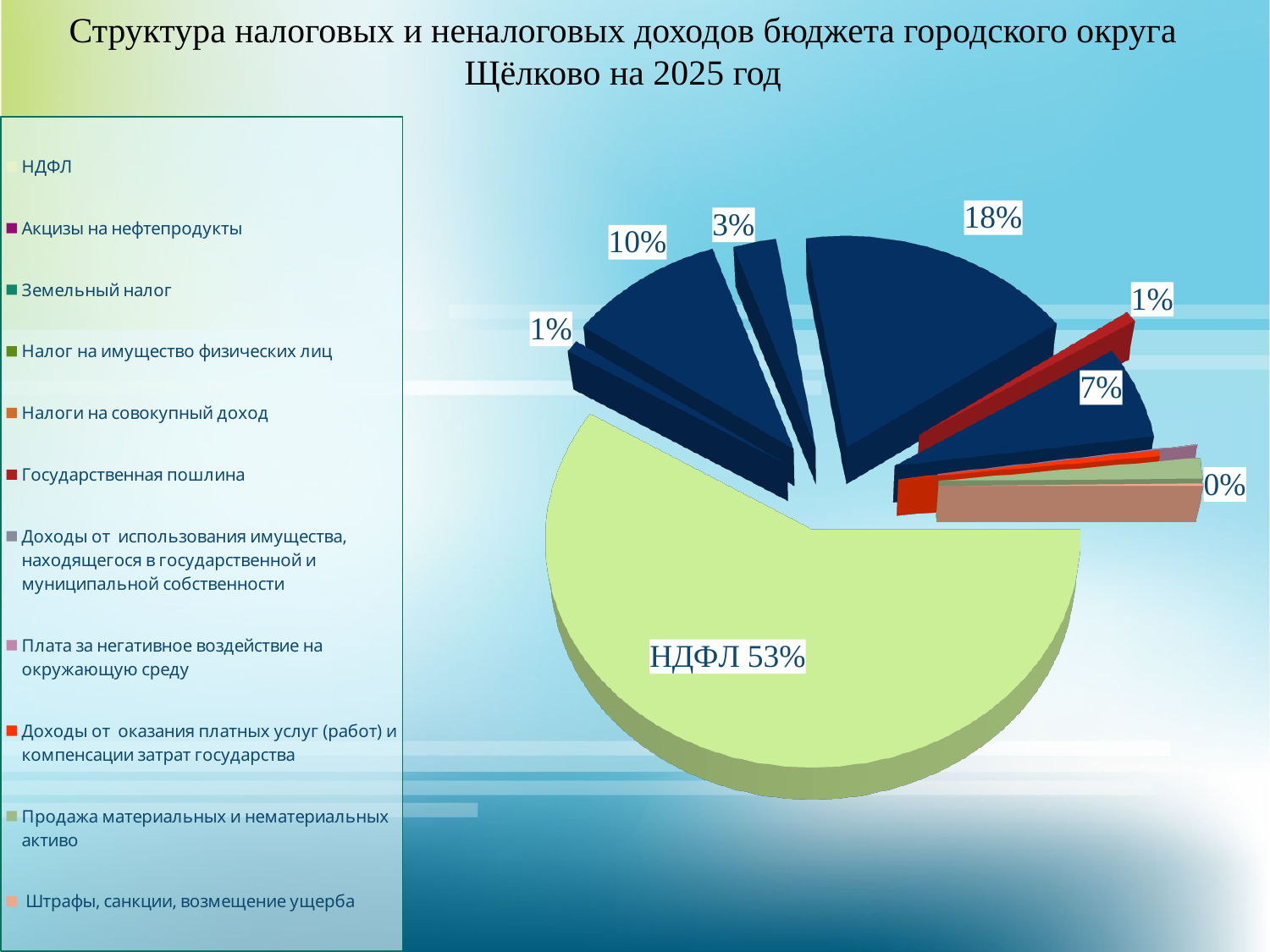
What is the second-largest percentage label shown on the pie? 18% What share of the pie does НДФЛ account for? 53% By how many percentage points does the НДФЛ slice (53%) exceed the 18% slice? 35% What is the title of the chart? Структура налоговых и неналоговых доходов бюджета городского округа Щёлково на 2025 год How many entries does the legend list? 11 Which category has the largest slice of the pie? НДФЛ How many percentage labels are printed on the pie? 8 Which is larger: the НДФЛ slice or the slice labeled 18%? НДФЛ What is the smallest percentage label shown on the pie? 0% What kind of chart is shown on the slide? pie chart What is the last entry listed in the legend? Штрафы, санкции, возмещение ущерба Is the share for НДФЛ greater or less than 50%? greater